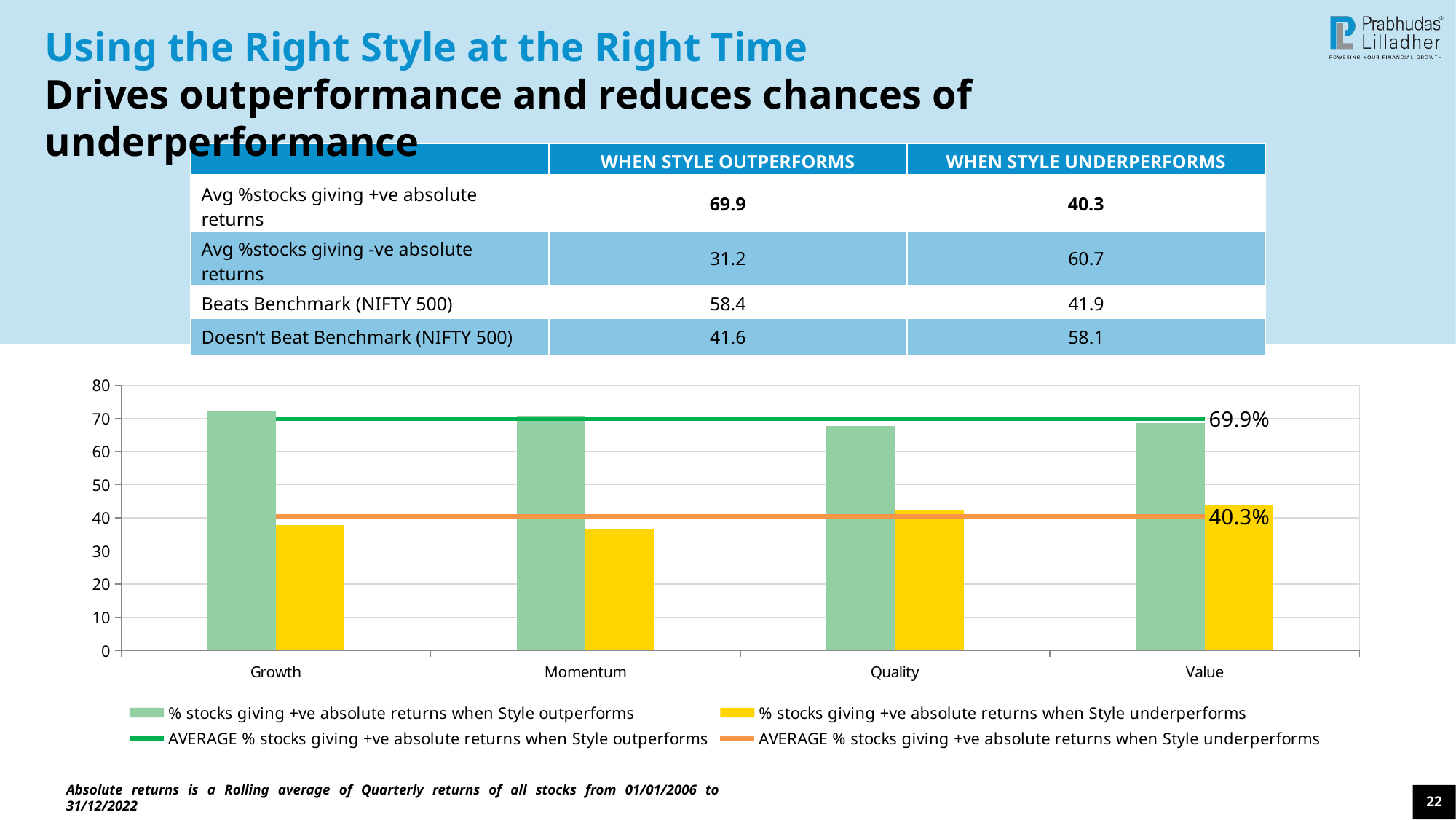
Is the value for Quality in the % stocks giving +ve absolute returns when Style outperforms series greater or less than 60? greater Which style has the highest bar for % stocks giving +ve absolute returns when Style outperforms? Growth Is the value for Momentum in the % stocks giving +ve absolute returns when Style underperforms series greater or less than 40? less What value is labelled on the orange average line for % stocks giving +ve absolute returns when Style underperforms? 40.3% For Growth, which is larger: the bar for when Style outperforms or the bar for when Style underperforms? when Style outperforms How many series does the chart's legend list? 4 How many style categories are shown on the x axis of the chart? 4 In the % stocks giving +ve absolute returns when Style underperforms series, which is larger: Quality or Momentum? Quality What value is labelled on the green average line for % stocks giving +ve absolute returns when Style outperforms? 69.9% What is the difference between the labelled average when Style outperforms (69.9%) and the labelled average when Style underperforms (40.3%)? 29.6% What colour are the bars for % stocks giving +ve absolute returns when Style underperforms? yellow What kind of chart is shown on the slide? combination bar and line chart